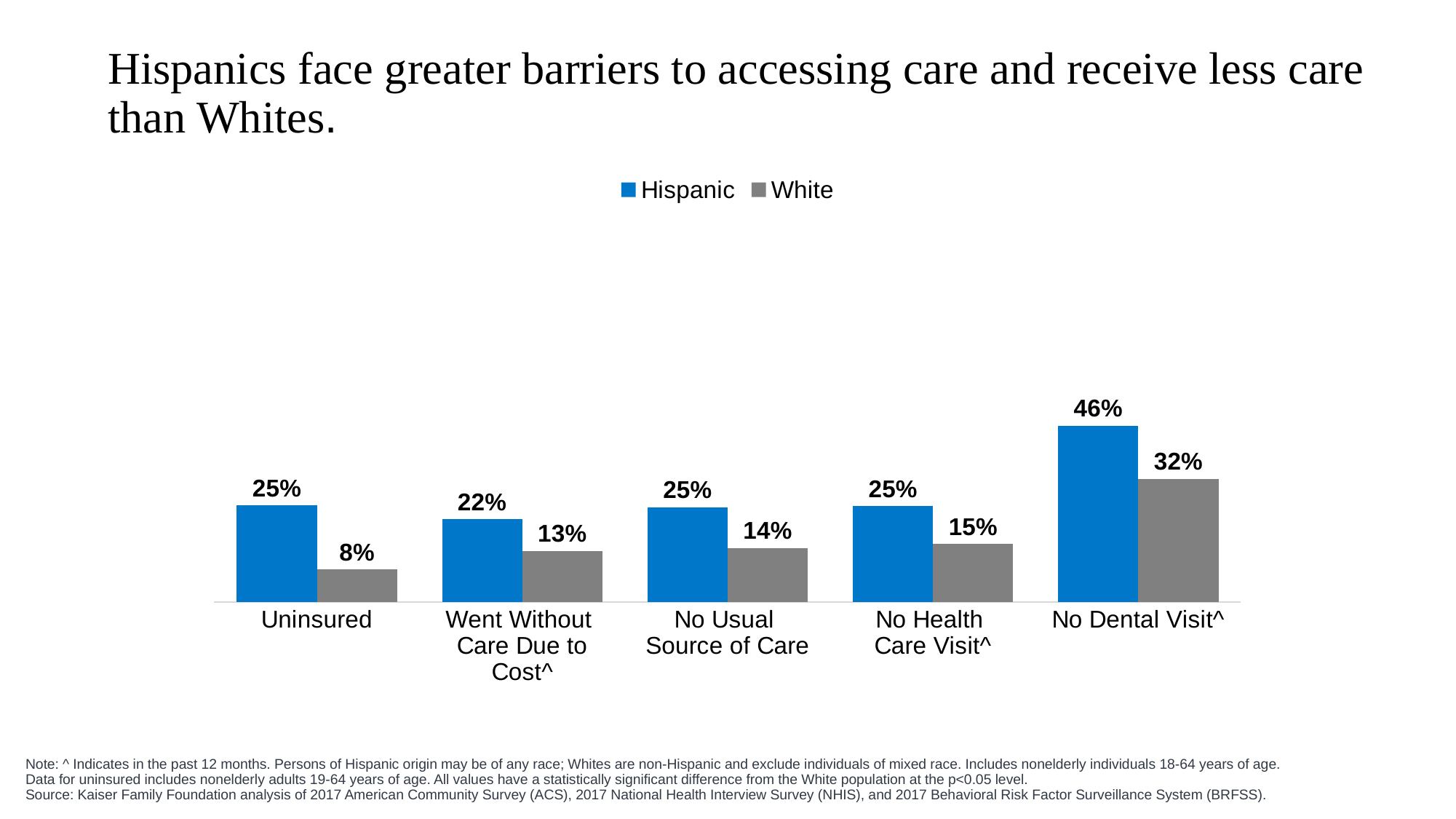
What is the value for White in the No Dental Visit^ category? 32% How many categories are shown on the x axis? 5 What is the value for Hispanic in the Uninsured category? 25% How many series does the legend list? 2 What is the difference between the Hispanic and White values in the Uninsured category? 17% Which category has the lowest value for White? Uninsured What is the difference between the Hispanic and White values in the No Dental Visit^ category? 14% What kind of chart is shown on the slide? Bar chart What is the value for Hispanic in the No Health Care Visit^ category? 25% What is the value for White in the Went Without Care Due to Cost^ category? 13% Which category has the highest value for Hispanic? No Dental Visit^ Which is larger in the No Usual Source of Care category, the Hispanic value or the White value? Hispanic